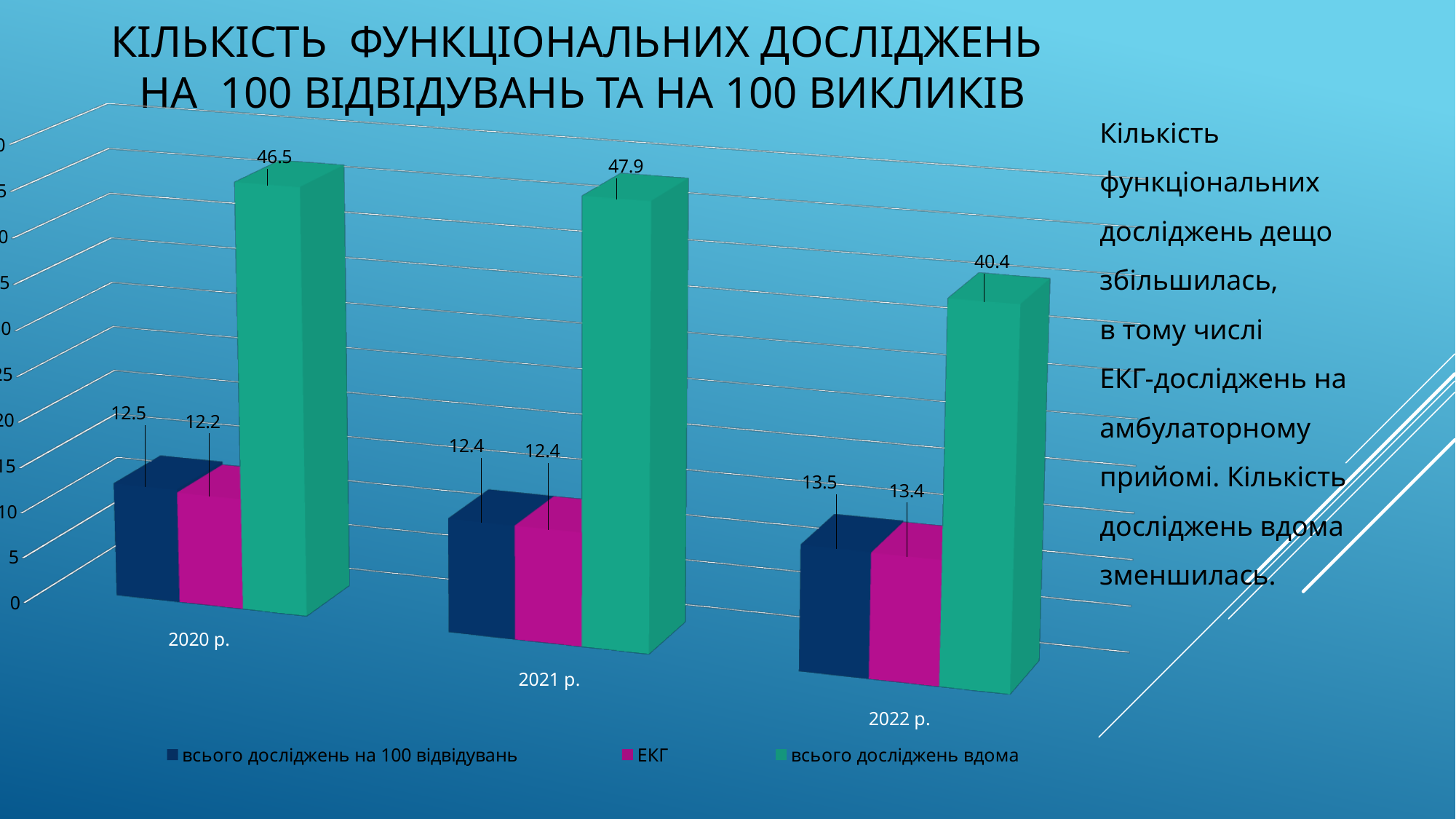
What is the value for "всього досліджень на 100 відвідувань" in 2021 р.? 12.4 In which year is the value for "всього досліджень вдома" lowest? 2022 р. What kind of chart is shown on the slide? Bar chart In which year is the value for "всього досліджень вдома" highest? 2021 р. Does the value for "ЕКГ" rise or fall from 2020 р. to 2022 р.? Rise What is the difference between the "всього досліджень вдома" values for 2021 р. and 2022 р.? 7.5 How many year categories are shown on the x axis? 3 What is the value for "ЕКГ" in 2022 р.? 13.4 How many series does the legend list? 3 Which colour represents the "ЕКГ" series in the legend? Magenta Which is larger: the "всього досліджень на 100 відвідувань" value for 2022 р. or for 2020 р.? 2022 р. What is the value for "всього досліджень вдома" in 2020 р.? 46.5